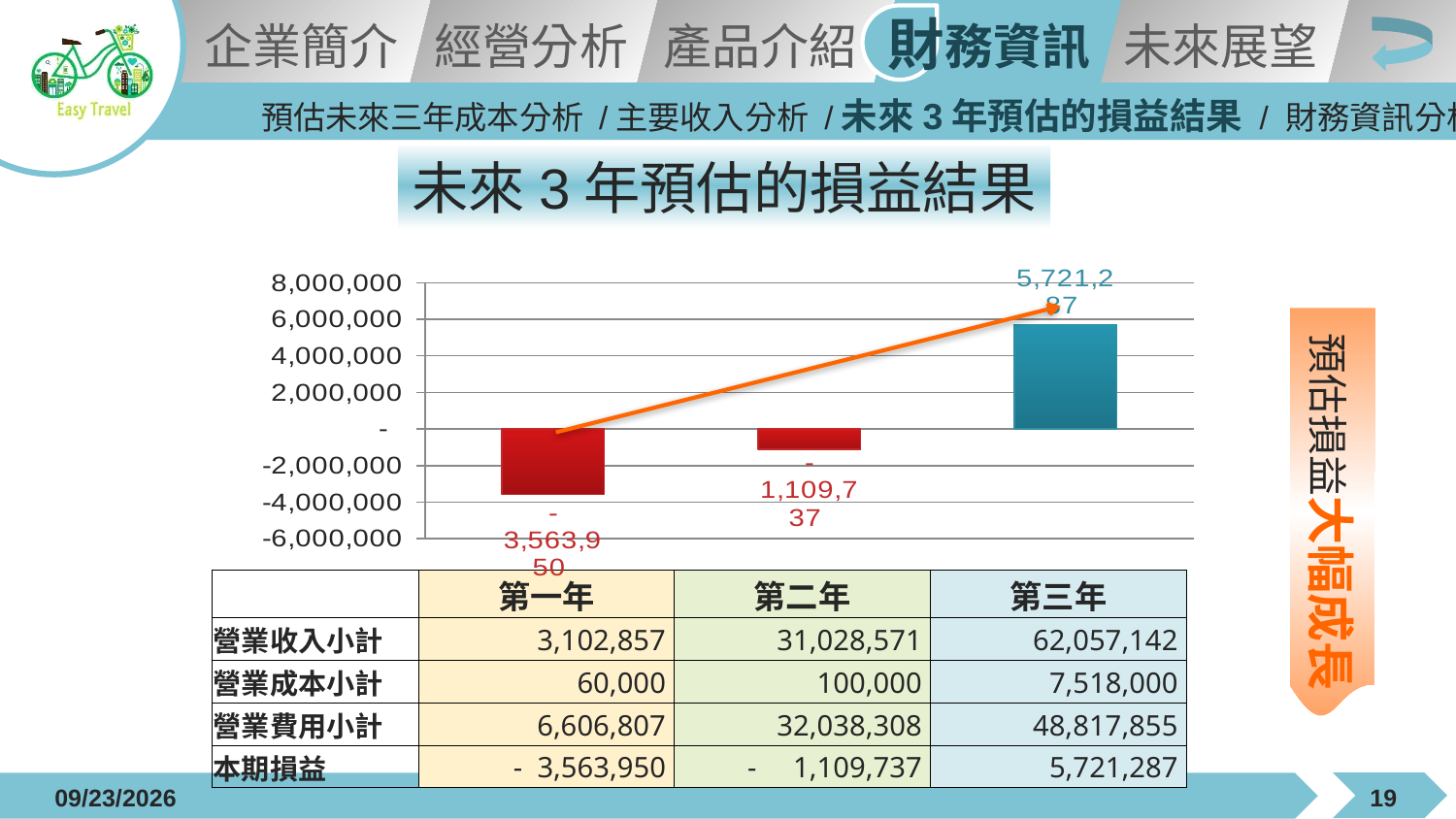
Which bar has the highest value? the third (rightmost) bar Do the bar values rise or fall from left to right across the chart? rise How many bars are plotted in the chart? 3 Is the value of the third bar greater or less than 4,000,000? greater Is the value of the first bar greater or less than -2,000,000? less What kind of chart is shown on the slide? bar chart What is the difference between the third bar's value (5,721,287) and the second bar's value (-1,109,737)? 6,831,024 Which bar has the lowest value? the first (leftmost) bar What is the value shown by the data label on the first (leftmost) bar? -3,563,950 What is the value shown by the data label on the third (rightmost) bar? 5,721,287 Which is larger, the value of the first bar or the value of the second bar? the second bar What is the value shown by the data label on the second (middle) bar? -1,109,737